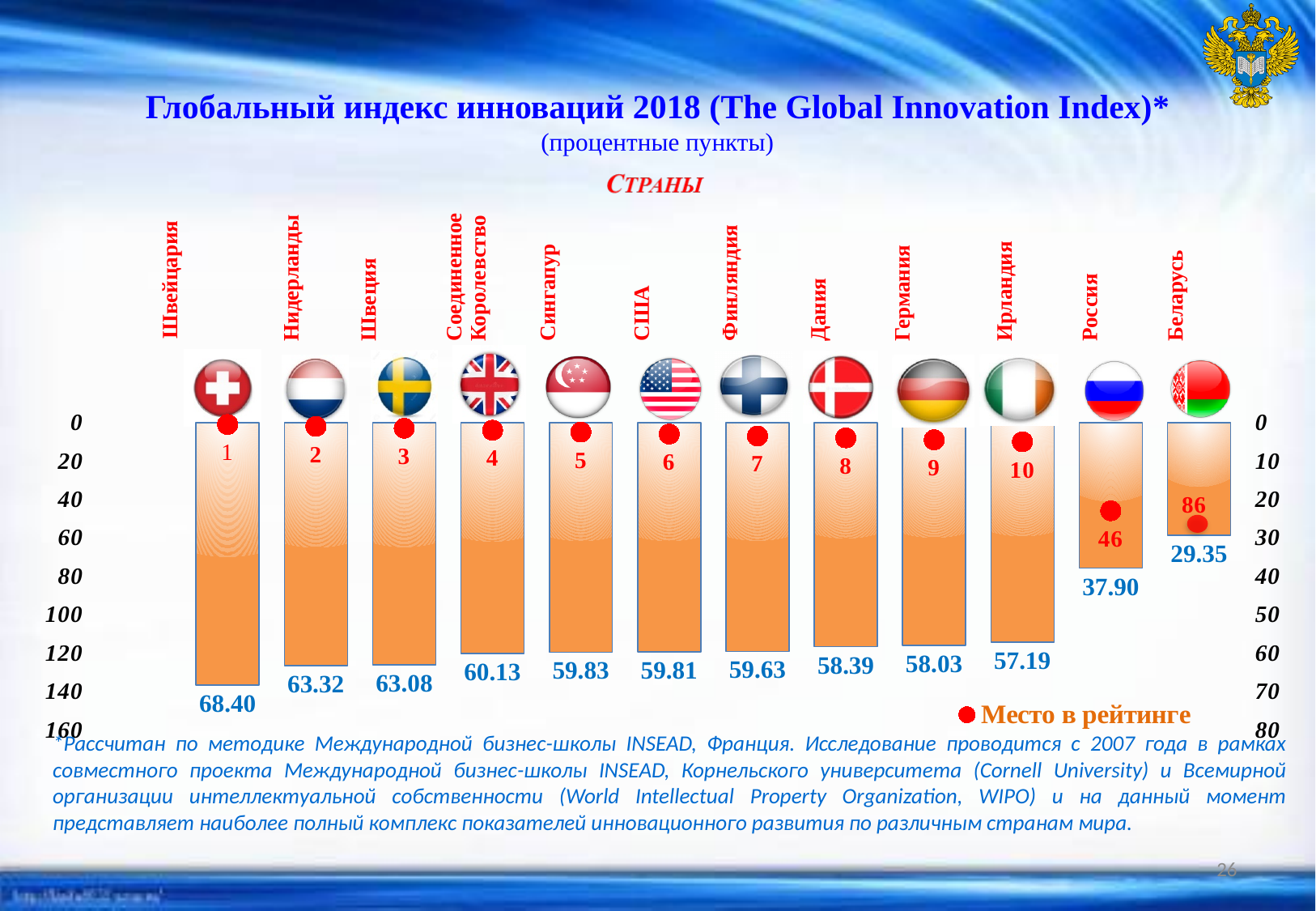
What rank (место в рейтинге) is shown for Россия? 46 What is the value shown for Беларусь? 29.35 What is the difference between the values for Швейцария and Россия? 30.50 Which country has the highest index value on the chart? Швейцария Which has a larger index value, Германия or Ирландия? Германия What rank (место в рейтинге) is shown for Беларусь? 86 What is the Global Innovation Index 2018 value shown for Швейцария? 68.40 How many countries are shown on the chart? 12 What type of chart is used on the slide? Bar chart What is the value shown for Россия? 37.90 Which country has the lowest index value on the chart? Беларусь What is the difference between the values for Россия and Беларусь? 8.55